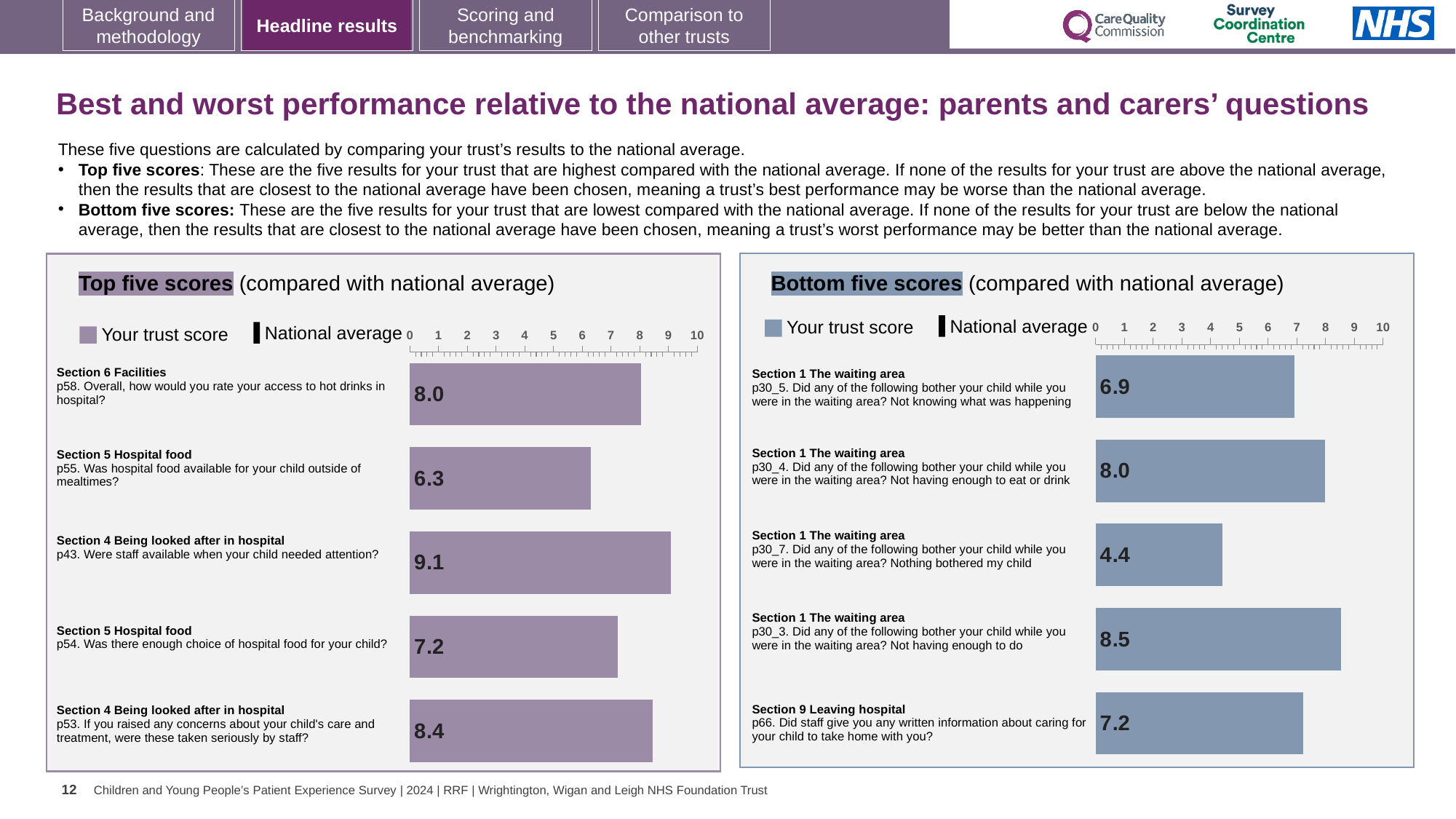
In the Bottom five scores chart, which question has the lowest trust score? p30_7. Nothing bothered my child In the Bottom five scores chart, which has the larger trust score: p30_5 (Not knowing what was happening) or p66 (written information to take home)? p66 In the Top five scores chart, what is the difference between the trust scores for p43 and p55? 2.8 In the Top five scores chart, what is the trust score for p58 (access to hot drinks in hospital)? 8.0 In the Top five scores chart, which question has the highest trust score? p43. Were staff available when your child needed attention? How many bars are plotted in the Top five scores chart? 5 In the Top five scores chart, what is the trust score for p53 (concerns about your child's care taken seriously)? 8.4 In the Top five scores chart, which question has the lowest trust score? p55. Was hospital food available for your child outside of mealtimes? In the Bottom five scores chart, which question has the highest trust score? p30_3. Not having enough to do What kind of chart is the Bottom five scores chart? Bar chart In the Bottom five scores chart, what is the trust score for p30_7 (Nothing bothered my child)? 4.4 In the Bottom five scores chart, is the trust score for p30_4 (Not having enough to eat or drink) greater or less than 5? greater